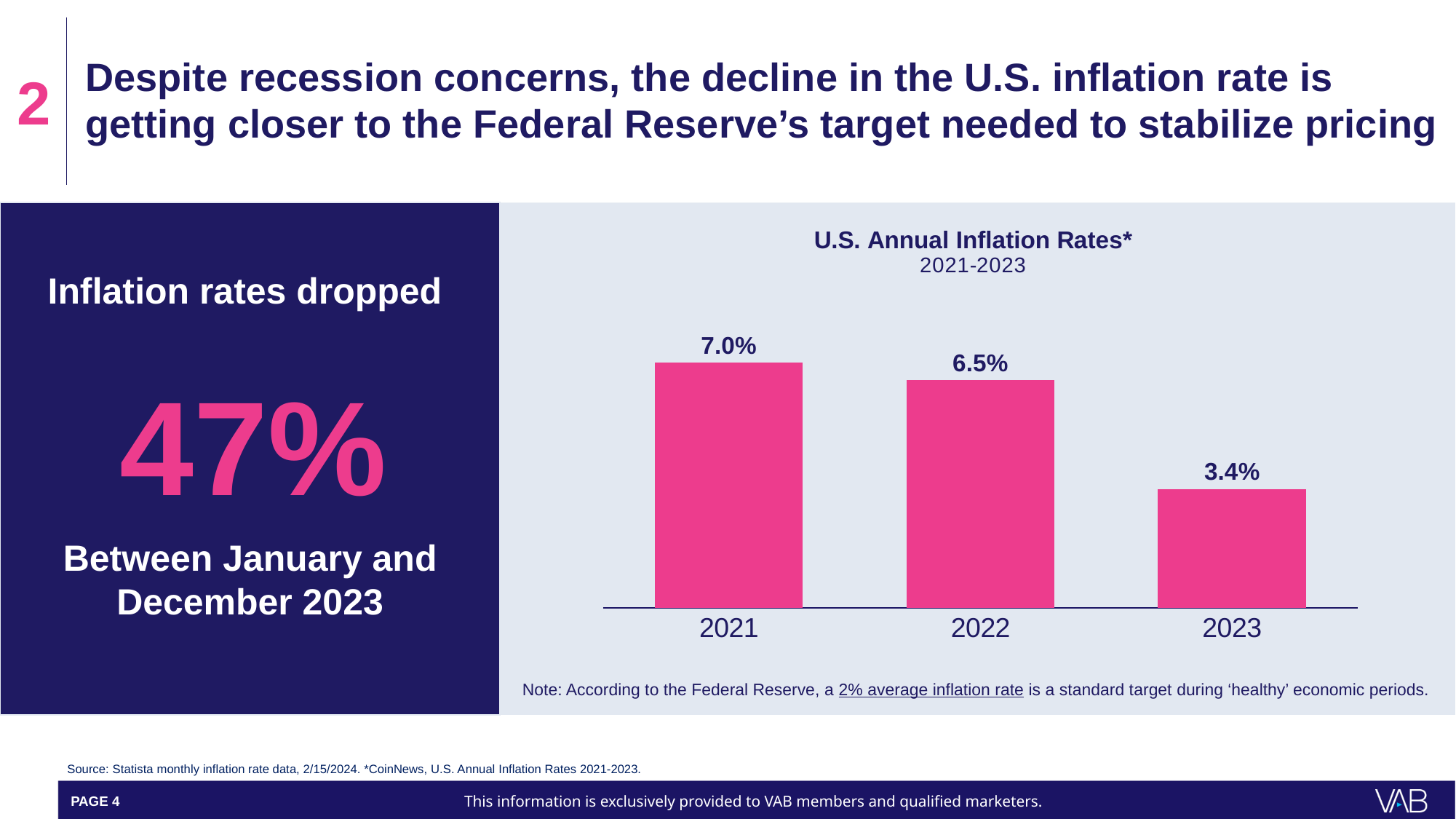
What was the U.S. annual inflation rate in 2022? 6.5% What is the difference between the 2021 and 2023 inflation rates? 3.6% Which year had a higher inflation rate, 2022 or 2023? 2022 Do the inflation rates rise or fall from 2021 to 2023? Fall Which year has the lowest inflation rate in the chart? 2023 What type of chart is used to show the U.S. annual inflation rates? Bar chart What is the difference between the 2021 and 2022 inflation rates? 0.5% What was the U.S. annual inflation rate in 2021? 7.0% What is the title of the chart? U.S. Annual Inflation Rates* 2021-2023 Which year has the highest inflation rate in the chart? 2021 What was the U.S. annual inflation rate in 2023? 3.4% How many years are shown in the chart? 3